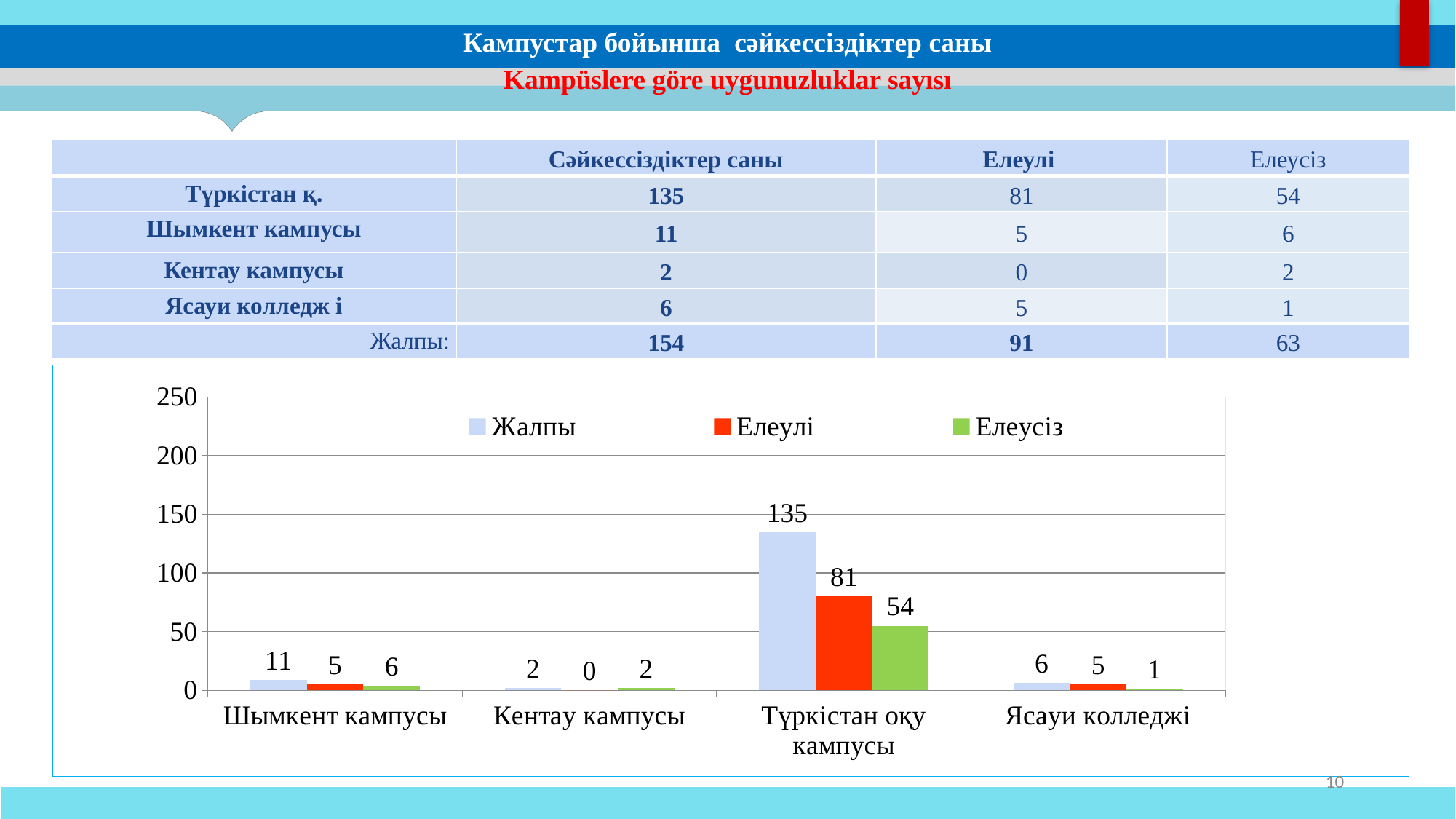
How many series does the chart legend list? 3 What is the Елеулі value for Шымкент кампусы in the chart? 5 Is the Жалпы value for Түркістан оқу кампусы greater or less than 100? greater What is the Елеусіз value for Ясауи колледжі in the chart? 1 Which campus has the highest Жалпы value in the chart? Түркістан оқу кампусы What is the difference between the Елеулі and Елеусіз values for Түркістан оқу кампусы? 27 What type of chart is shown on the slide? bar chart What is the Жалпы value for Түркістан оқу кампусы in the chart? 135 What colour represents the Елеулі series in the chart? red How many campuses are shown on the x axis of the chart? 4 Which campus has the lowest Елеулі value in the chart? Кентау кампусы